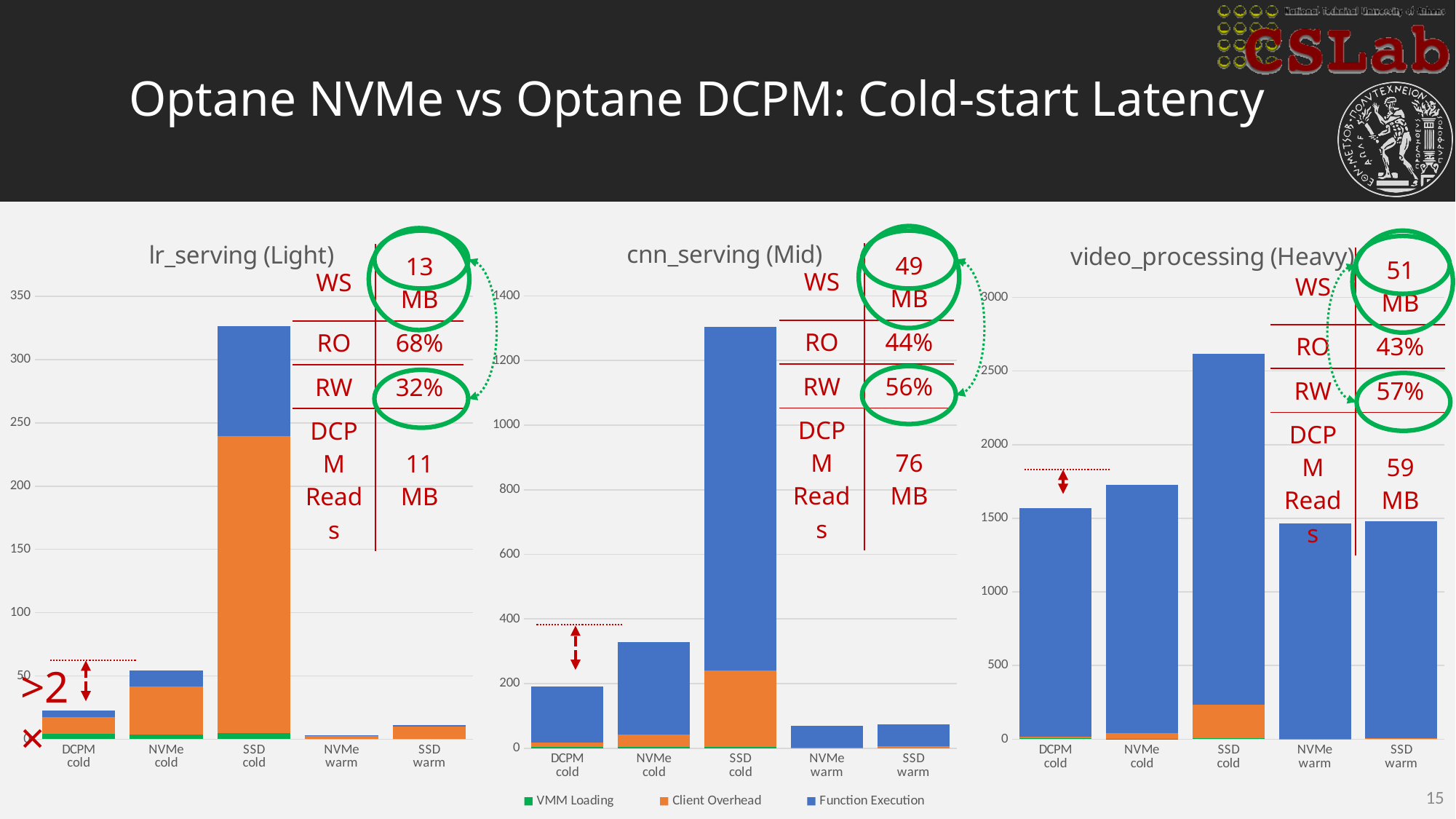
In the cnn_serving (Mid) chart, which is larger, the total for DCPM cold or NVMe cold? NVMe cold How many series does the legend list for the charts? 3 In the lr_serving (Light) chart, is the total for SSD cold greater or less than 300? greater In the video_processing (Heavy) chart, which is larger, the total for DCPM cold or NVMe cold? NVMe cold In the lr_serving (Light) chart, is the total for DCPM cold greater or less than 50? less How many categories are shown on the x axis of the cnn_serving (Mid) chart? 5 What kind of chart is the lr_serving (Light) chart? stacked bar chart In the cnn_serving (Mid) chart, is the total for NVMe cold greater or less than 200? greater In the lr_serving (Light) chart, which category has the highest total bar? SSD cold In the cnn_serving (Mid) chart, which category has the highest total bar? SSD cold Which series is shown in orange in the legend? Client Overhead